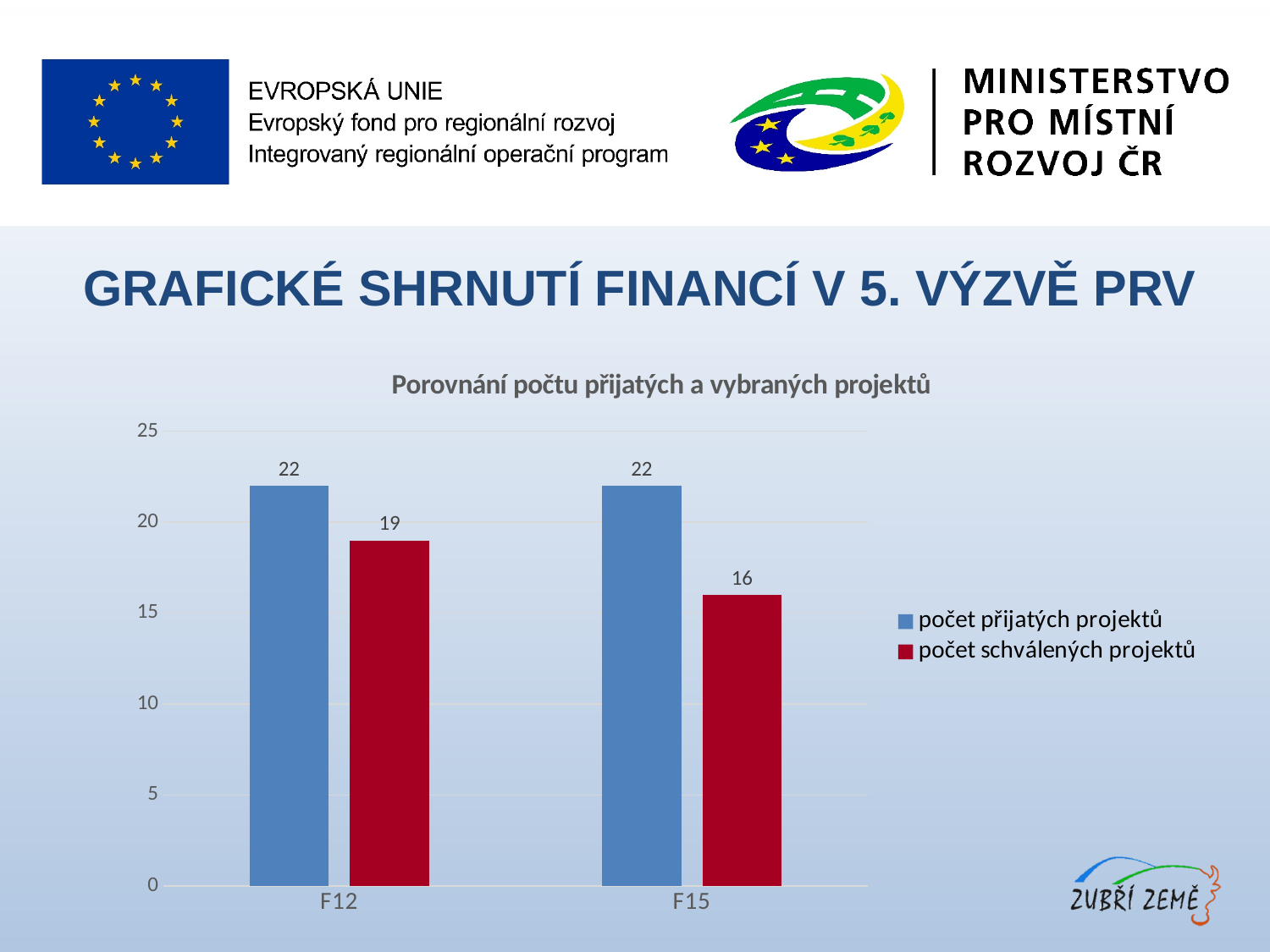
What is the difference between počet přijatých projektů and počet schválených projektů for F15? 6 What is the value of počet schválených projektů for F15? 16 How many categories are shown on the x axis? 2 What is the value of počet schválených projektů for F12? 19 How many series does the legend list? 2 What is the title of the chart? Porovnání počtu přijatých a vybraných projektů Which category has the lowest value for počet schválených projektů? F15 Which is larger for F12: počet přijatých projektů or počet schválených projektů? počet přijatých projektů What kind of chart is shown on the slide? bar chart What is the value of počet přijatých projektů for F15? 22 What is the value of počet přijatých projektů for F12? 22 What is the difference between počet přijatých projektů and počet schválených projektů for F12? 3